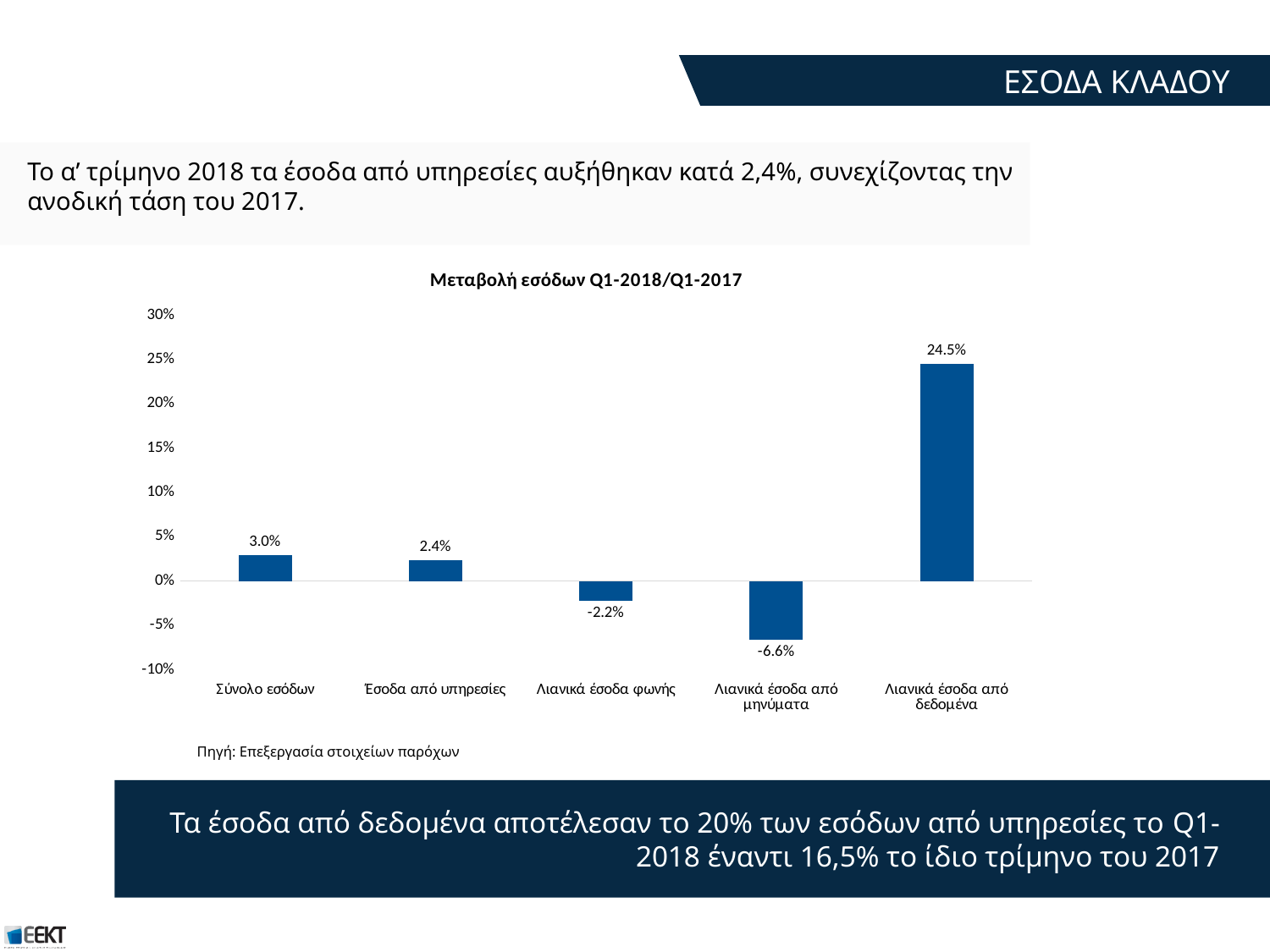
What is the value for Λιανικά έσοδα από δεδομένα? 24.5% What is the difference between the values for Λιανικά έσοδα από δεδομένα and Σύνολο εσόδων? 21.5% How many categories are shown in the chart? 5 What is the value for Λιανικά έσοδα φωνής? -2.2% What kind of chart is shown on the slide? Bar chart Which category has the highest value in the chart? Λιανικά έσοδα από δεδομένα What is the value for Λιανικά έσοδα από μηνύματα? -6.6% What is the value for Έσοδα από υπηρεσίες? 2.4% Which is larger, the value for Σύνολο εσόδων or the value for Έσοδα από υπηρεσίες? Σύνολο εσόδων What is the title of the chart? Μεταβολή εσόδων Q1-2018/Q1-2017 Which category has the lowest value in the chart? Λιανικά έσοδα από μηνύματα What is the value for Σύνολο εσόδων in the chart? 3.0%